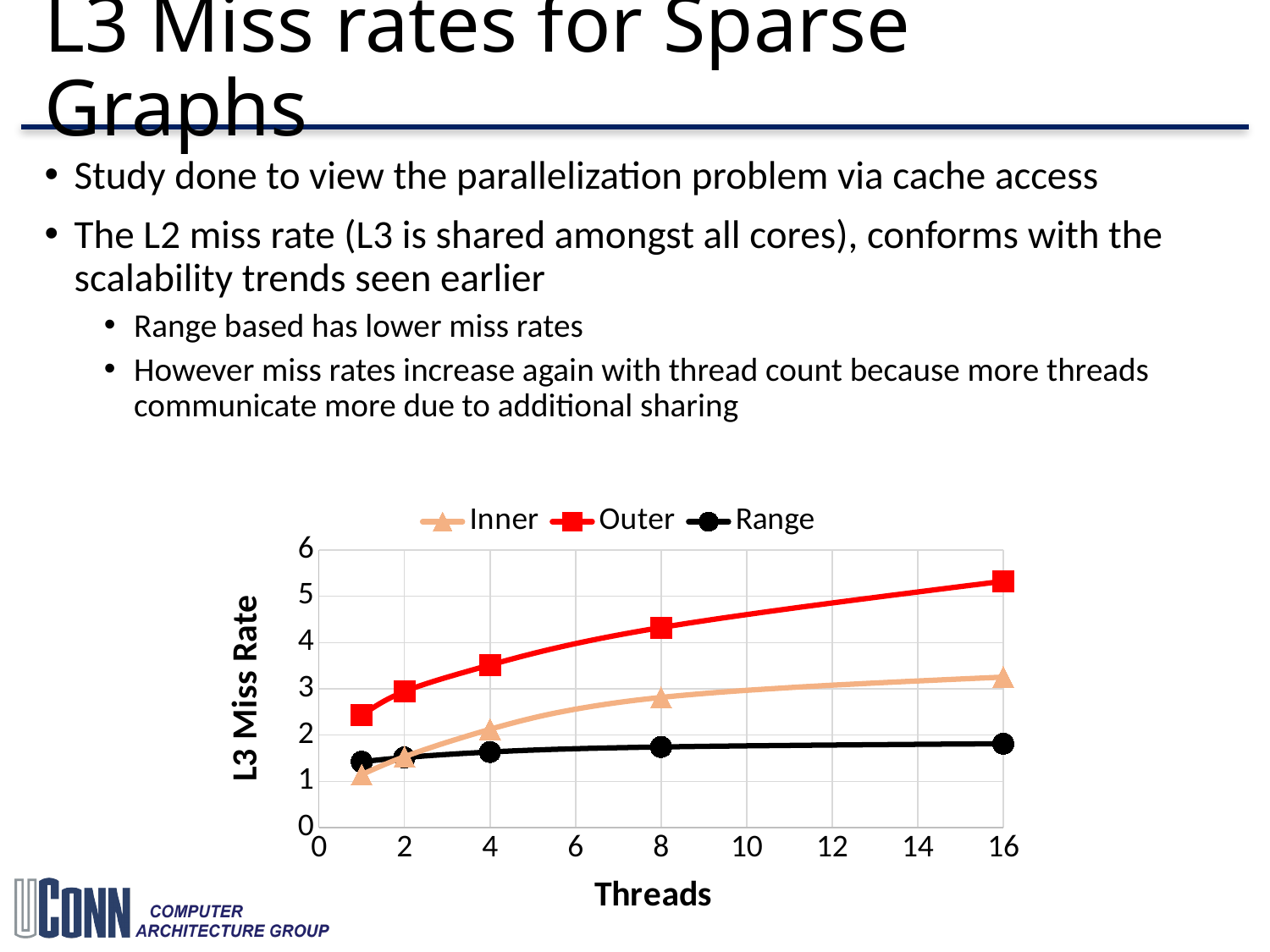
Does the L3 miss rate for Outer rise or fall as the number of threads increases? rise What kind of chart is shown on the slide? line chart Is the L3 miss rate for Outer at 16 threads greater or less than 5? greater Which series are listed in the chart legend? Inner, Outer, Range At 8 threads, which series has the larger L3 miss rate, Inner or Range? Inner Which series has the highest L3 miss rate at 16 threads? Outer Is the L3 miss rate for Inner at 8 threads greater or less than 3? less What is the label of the y axis? L3 Miss Rate Is the L3 miss rate for Range at 16 threads greater or less than 2? less Which series has the lowest L3 miss rate at 16 threads? Range How many series does the legend list? 3 How many data points are plotted for the Outer series? 5